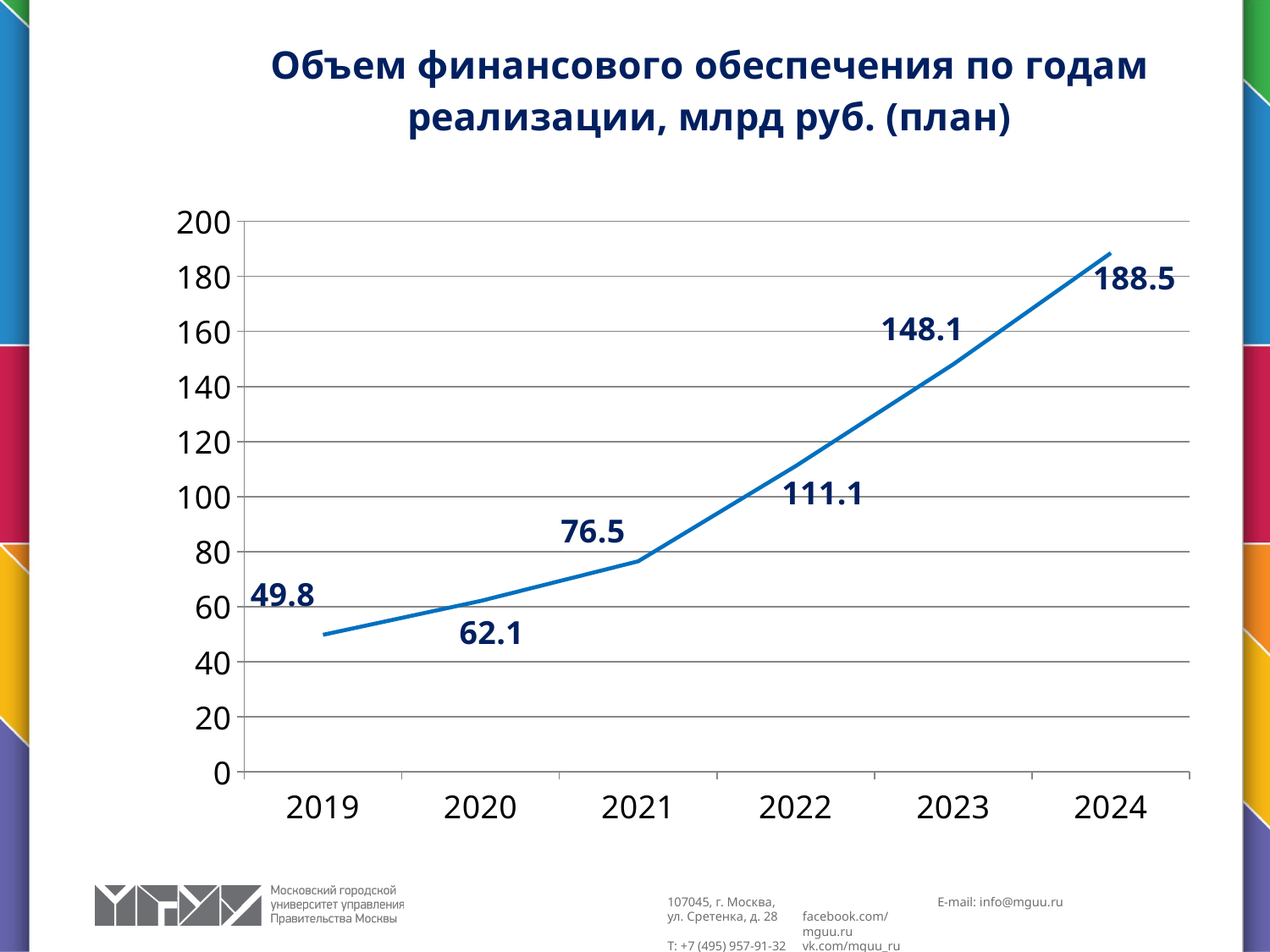
What kind of chart is shown on the slide? line chart How many years are plotted on the chart? 6 What is the difference between the values for 2022 and 2021? 34.6 Which year has the lowest value? 2019 Is the value for 2022 greater or less than 100? greater Which year has the highest value? 2024 What is the value for 2023? 148.1 What is the value for 2021? 76.5 Do the values rise or fall from 2019 to 2024? rise What is the value for 2019? 49.8 Which is larger, the value for 2020 or the value for 2022? 2022 What is the difference between the values for 2024 and 2023? 40.4